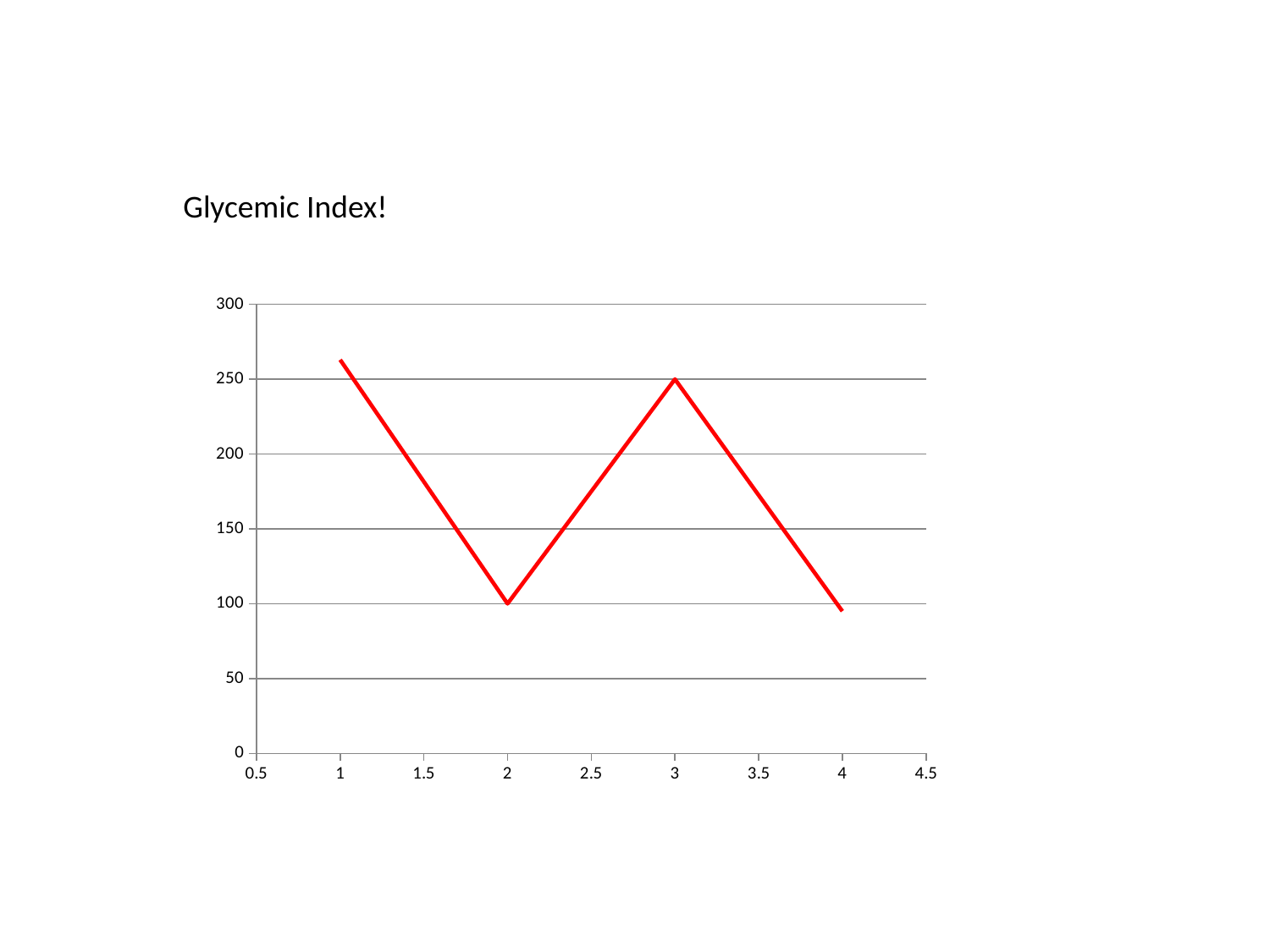
Is the value at x = 1 greater or less than 250? greater What is the value at x = 2? 100 Does the line rise or fall between x = 2 and x = 3? rise Does the line rise or fall between x = 1 and x = 2? fall Which x value has the highest plotted value? 1 Is the value at x = 4 greater or less than 150? less What colour is the plotted line? red What is the difference between the value at x = 3 and the value at x = 2? 150 How many data points are plotted on the line? 4 What kind of chart is shown on the slide? line chart What is the value at x = 3? 250 Which is larger, the value at x = 2 or the value at x = 3? x = 3